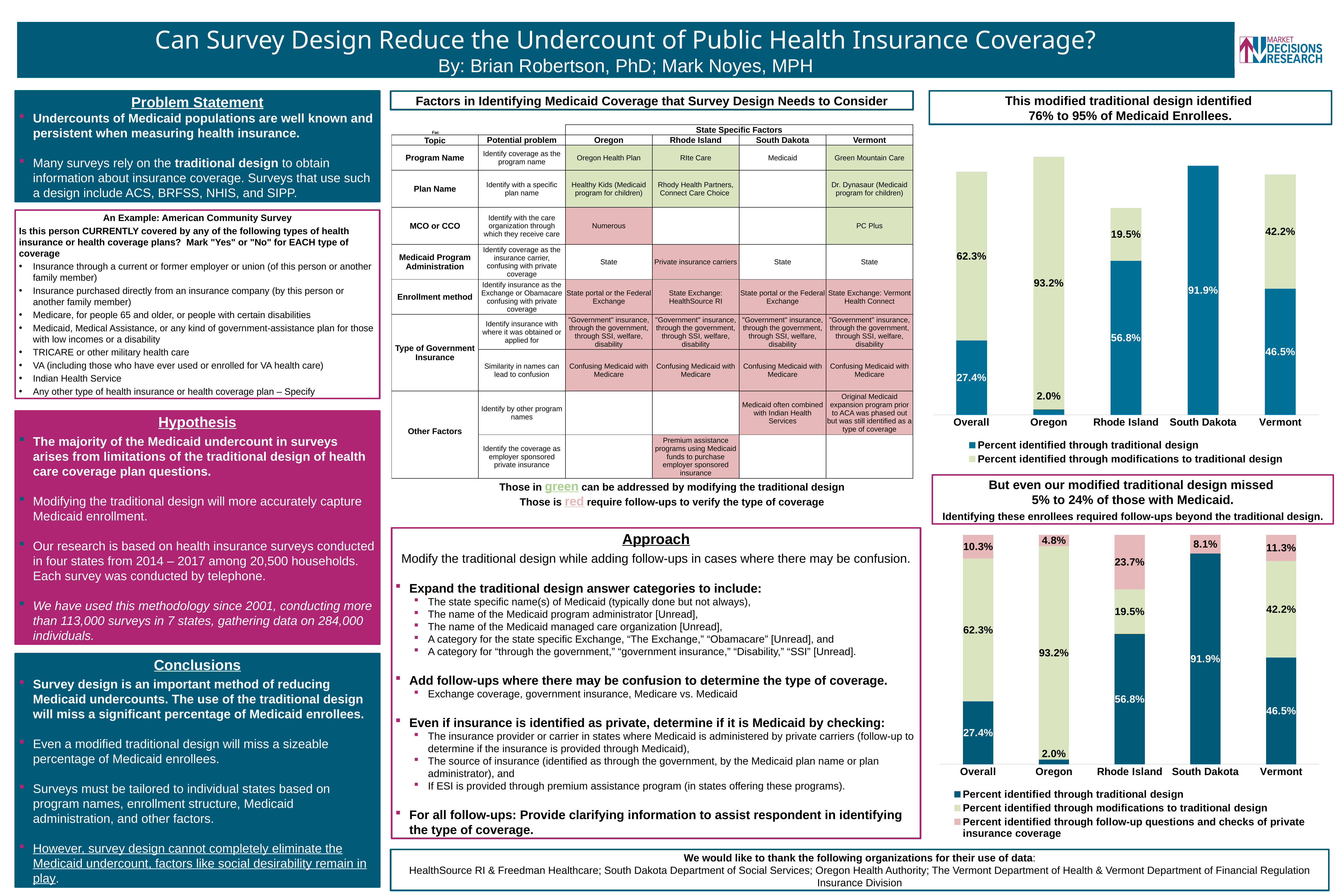
In the top-right chart, which state has the highest percent identified through the traditional design? South Dakota In the top-right chart, what is the total of the stacked bar for Overall? 89.7% In the bottom-right chart, which is larger: the percent identified through follow-up questions for Overall or for Oregon? Overall In the bottom-right chart, what is the difference between the percent identified through modifications to the traditional design for Vermont and for Rhode Island? 22.7% In the top-right chart, which category has the lowest percent identified through the traditional design? Oregon How many categories are shown on the x axis of the bottom-right chart? 5 What type of chart is the bottom-right chart? Stacked bar chart In the top-right chart, what percent of Medicaid enrollees in Rhode Island were identified through modifications to the traditional design? 19.5% In the bottom-right chart, how many series does the legend list? 3 In the top-right chart, how many series does the legend list? 2 In the bottom-right chart, what percent of Medicaid enrollees in Rhode Island were identified through follow-up questions and checks of private insurance coverage? 23.7% In the top-right chart, what percent of Medicaid enrollees in Oregon were identified through the traditional design? 2.0%